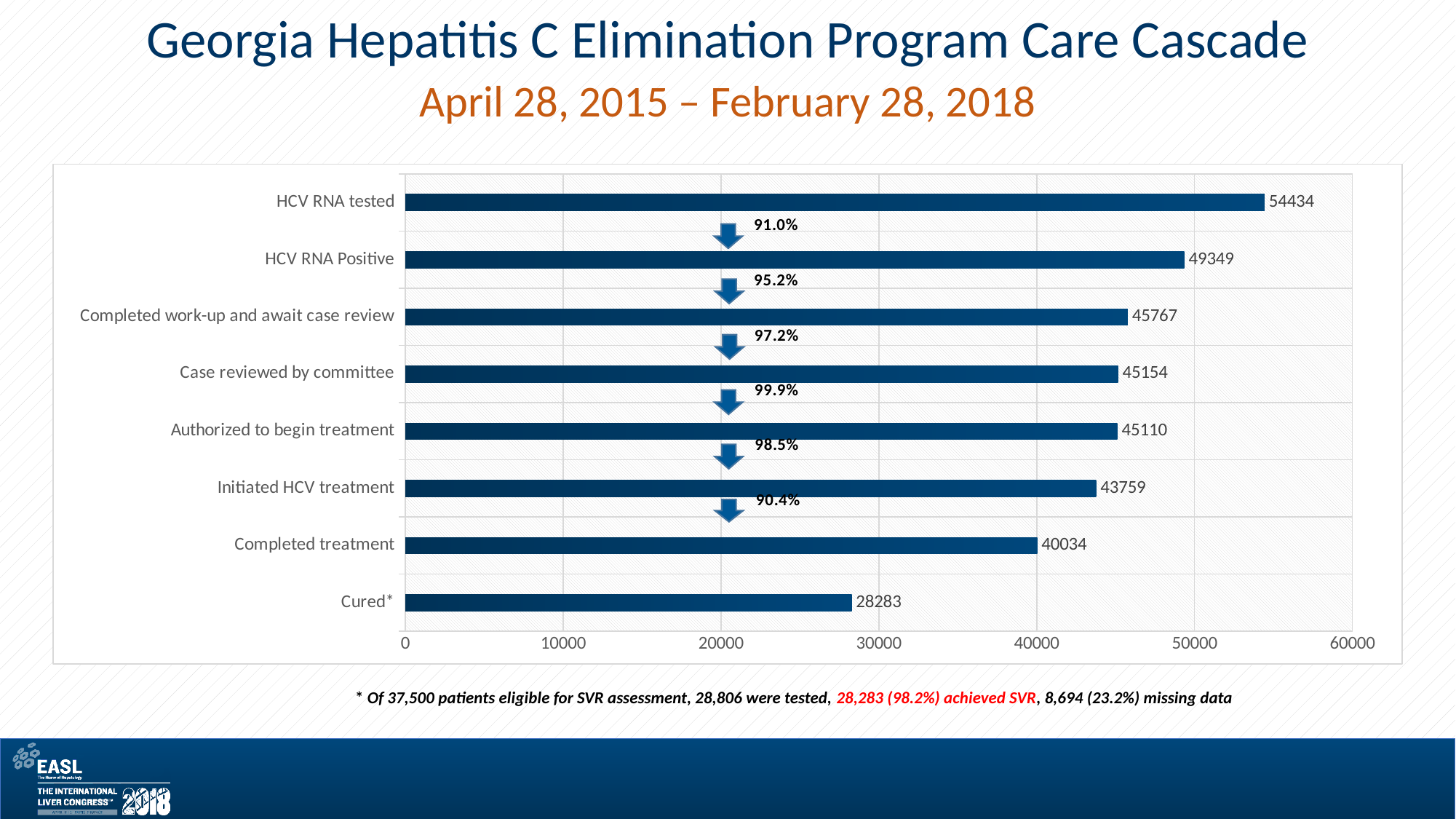
What is the difference between HCV RNA tested and HCV RNA Positive? 5085 What percentage is shown on the arrow between Initiated HCV treatment and Completed treatment? 90.4% Is the value for Cured* greater or less than 30000? less Which category has the highest value? HCV RNA tested What is the value for Completed treatment? 40034 What is the difference between Completed treatment and Cured*? 11751 What is the value for Initiated HCV treatment? 43759 What is the value for HCV RNA tested? 54434 Which is larger, Completed work-up and await case review or Case reviewed by committee? Completed work-up and await case review What kind of chart is shown on the slide? bar chart Which category has the lowest value? Cured* How many categories are shown in the chart? 8